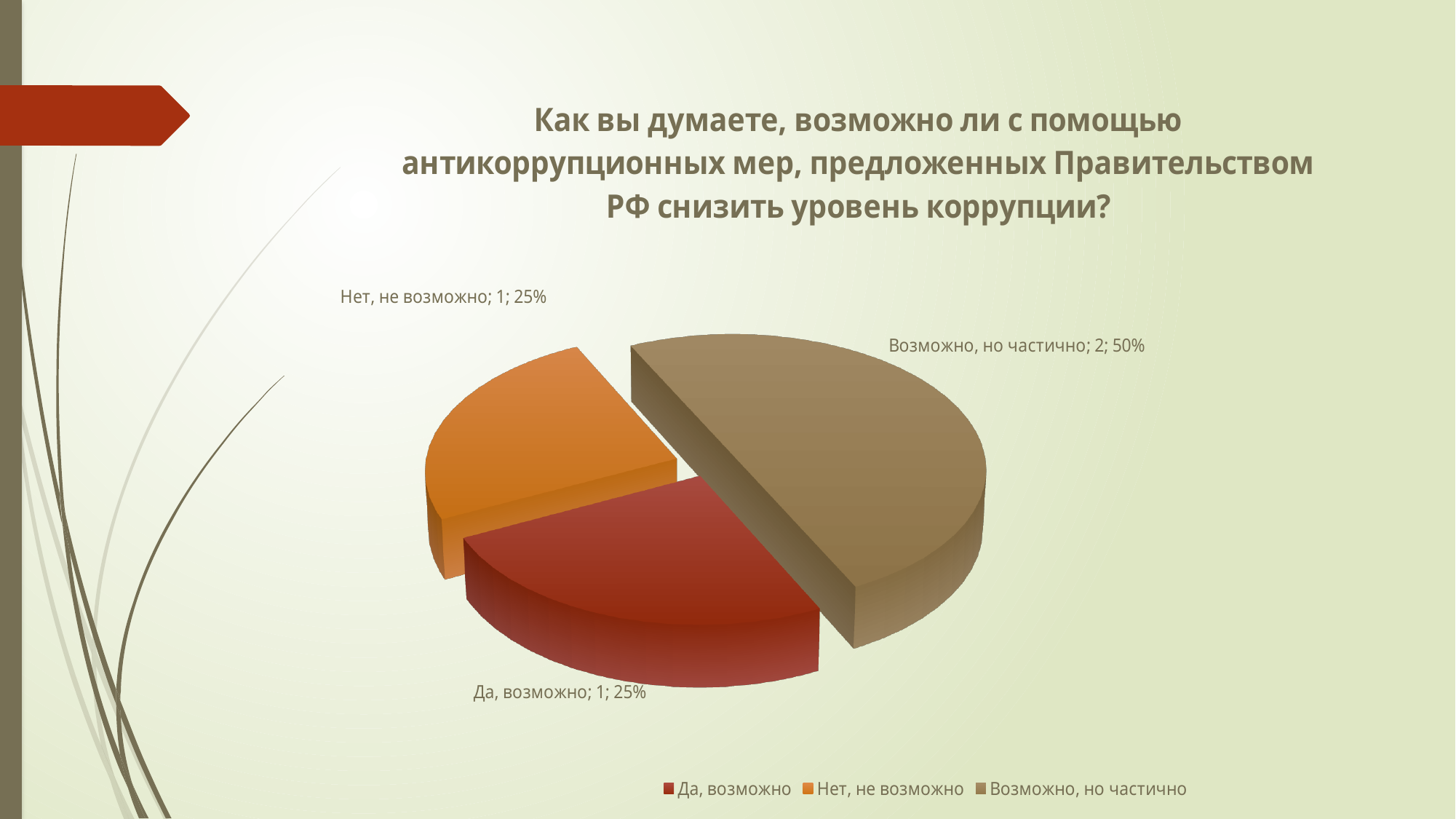
Which category has the largest slice of the pie? Возможно, но частично What is the value shown for "Возможно, но частично"? 2 What is the difference between the values for "Возможно, но частично" and "Да, возможно"? 1 What is the value shown for "Нет, не возможно"? 1 Which is larger: the value for "Возможно, но частично" or the value for "Нет, не возможно"? Возможно, но частично What kind of chart is shown on the slide? Pie chart What share of the pie does "Да, возможно" represent? 25% What share of the pie does "Возможно, но частично" represent? 50% How many entries does the legend list? 3 How many categories does the pie chart have? 3 What colour is the slice for "Да, возможно"? Red What is the total of all the values shown in the pie chart? 4